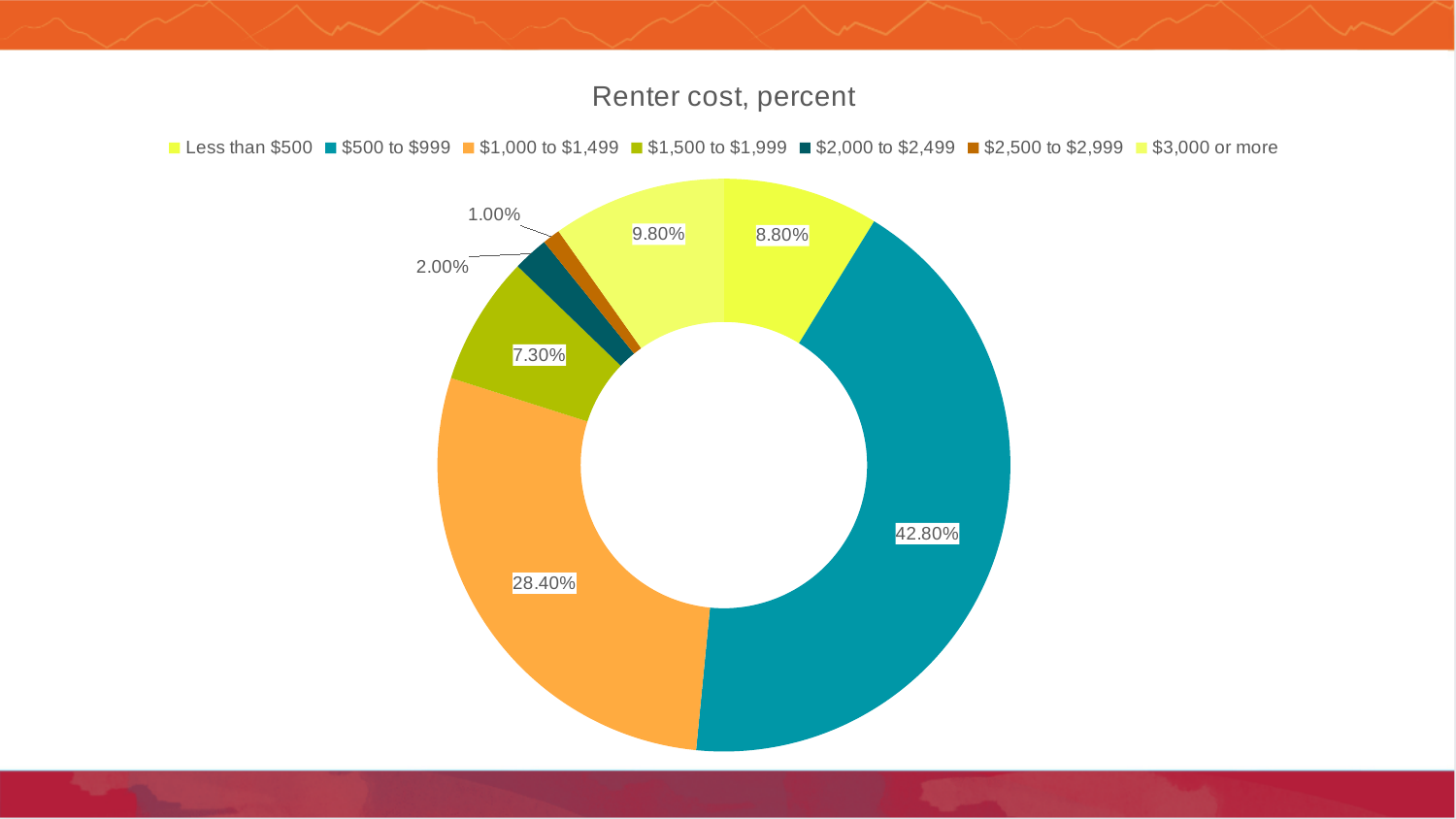
Which renter cost category has the smallest share? $2,500 to $2,999 What percentage of renters pay $1,500 to $1,999? 7.30% What percentage of renters pay $500 to $999? 42.80% What percentage of renters pay $3,000 or more? 9.80% What percentage of renters pay $1,000 to $1,499? 28.40% Which renter cost category has the largest share? $500 to $999 What percentage of renters pay less than $500? 8.80% What type of chart is shown on the slide? Doughnut (pie) chart Which is larger: the share for $3,000 or more or the share for less than $500? $3,000 or more How many renter cost categories does the legend list? 7 What is the title of the chart? Renter cost, percent What is the difference between the shares for $500 to $999 and $1,000 to $1,499? 14.40%